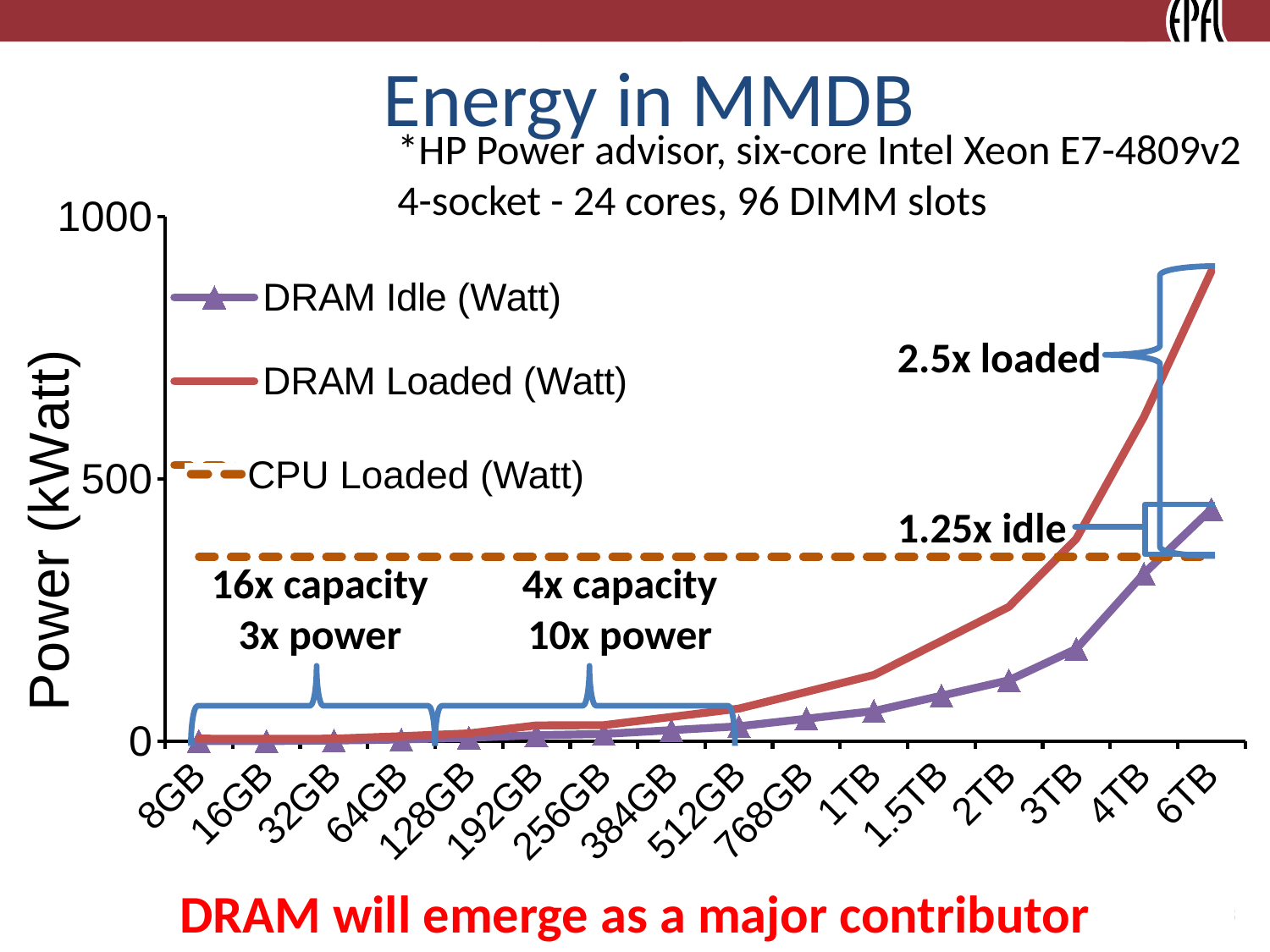
Is the value for DRAM Idle (Watt) at 6TB greater or less than 500? less Is the value for DRAM Loaded (Watt) at 2TB greater or less than 500? less Is the value for DRAM Loaded (Watt) at 6TB greater or less than 500? greater How many series does the legend list? 3 At 1TB, which is larger: CPU Loaded (Watt) or DRAM Loaded (Watt)? CPU Loaded (Watt) What is the label of the y axis? Power (kWatt) How many memory capacity categories are shown on the x axis? 16 Does the DRAM Loaded (Watt) series rise or fall as memory capacity increases along the x axis? rise At 6TB, which is larger: DRAM Loaded (Watt) or DRAM Idle (Watt)? DRAM Loaded (Watt) What kind of chart is shown on the slide? line chart What is the title of the chart? Energy in MMDB